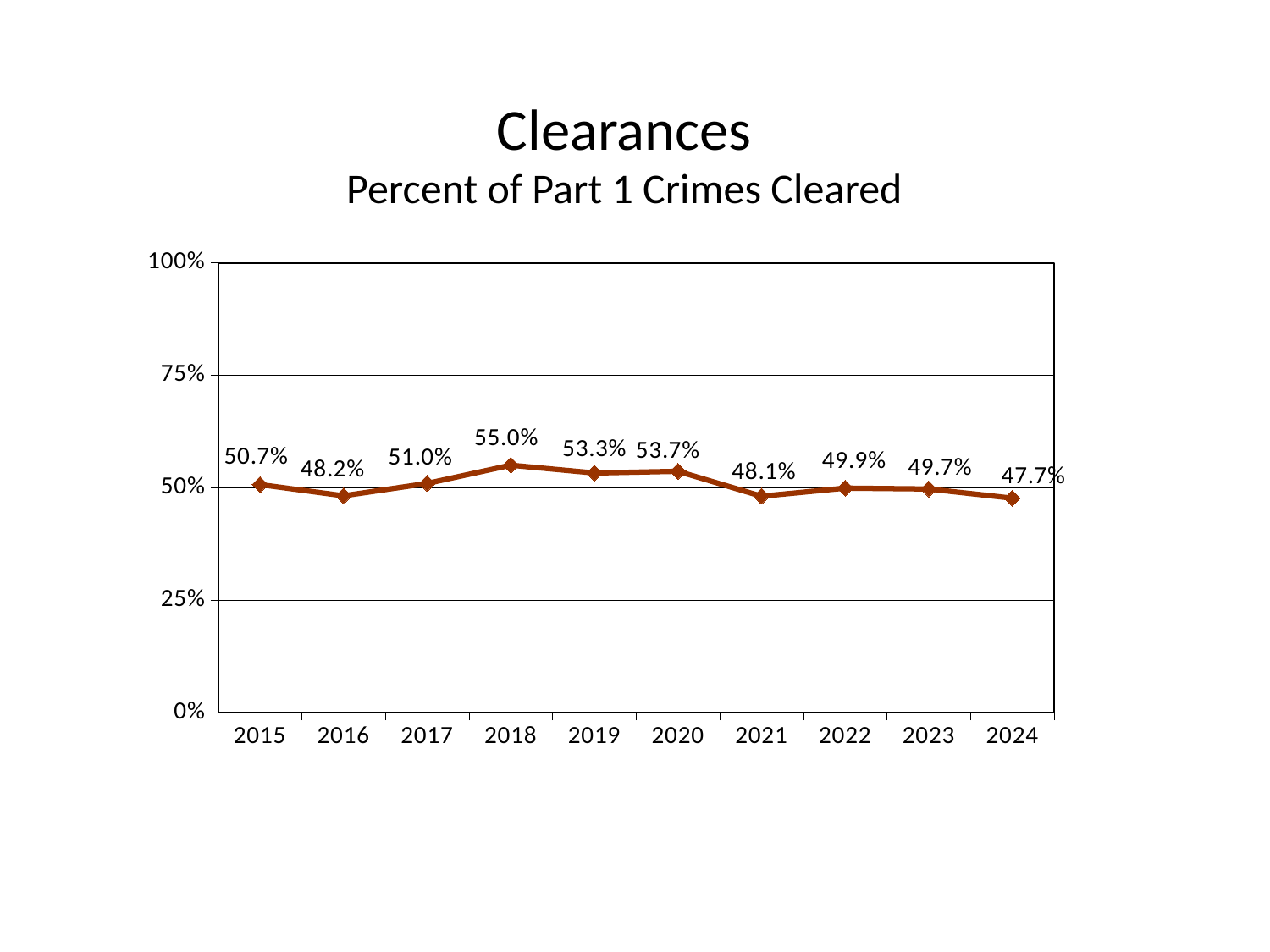
Is the value for 2020 greater or less than 50%? greater Which year has a higher clearance rate, 2017 or 2019? 2019 How many years are plotted on the chart? 10 What percent of Part 1 crimes were cleared in 2018? 55.0% What is the clearance rate shown for 2024? 47.7% What is the difference between the 2018 value and the 2024 value? 7.3% What kind of chart is shown on the slide? line chart Which year has the lowest percent of Part 1 crimes cleared? 2024 Which year has the highest percent of Part 1 crimes cleared? 2018 Does the clearance rate rise or fall from 2020 to 2021? fall What is the subtitle of the chart? Percent of Part 1 Crimes Cleared What value is plotted for 2021? 48.1%